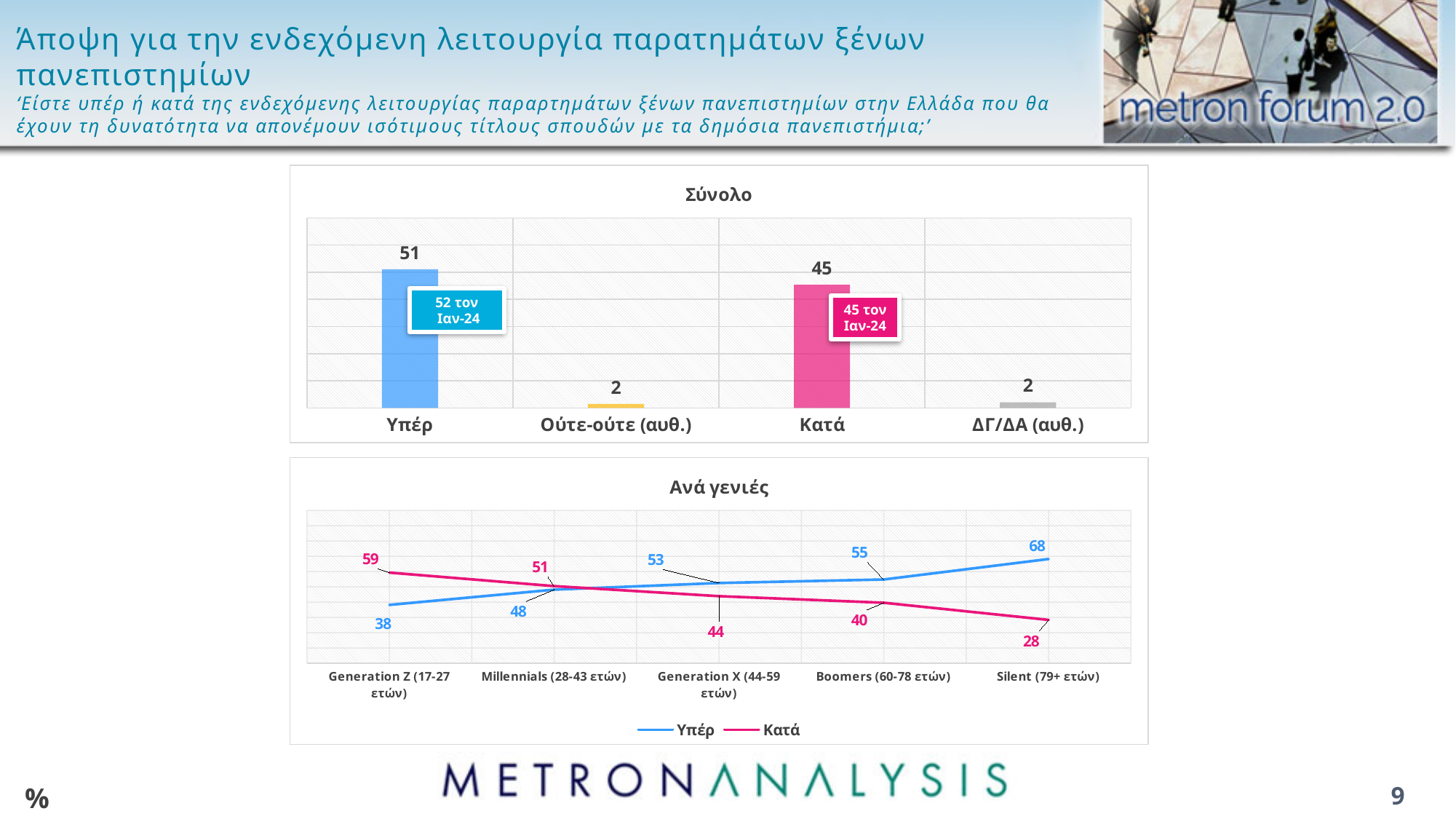
In the 'Ανά γενιές' chart, what is the Κατά value for Generation Z (17-27 ετών)? 59 In the 'Ανά γενιές' chart, does the Υπέρ line rise or fall from Generation Z to Silent? Rises In the 'Σύνολο' chart, what is the difference between the values for Υπέρ and Κατά? 6 In the 'Σύνολο' chart, what is the value for Κατά? 45 In the 'Ανά γενιές' chart, what is the Υπέρ value for Silent (79+ ετών)? 68 In the 'Ανά γενιές' chart, which generation has the lowest Κατά value? Silent (79+ ετών) What kind of chart is the 'Σύνολο' chart? Bar chart In the 'Σύνολο' chart, which category has the highest value? Υπέρ In the 'Ανά γενιές' chart, is the Υπέρ value or the Κατά value larger for Boomers (60-78 ετών)? Υπέρ In the 'Σύνολο' chart, what is the value for Υπέρ? 51 How many series does the legend of the 'Ανά γενιές' chart list? 2 In the 'Σύνολο' chart, how many categories are shown on the x axis? 4